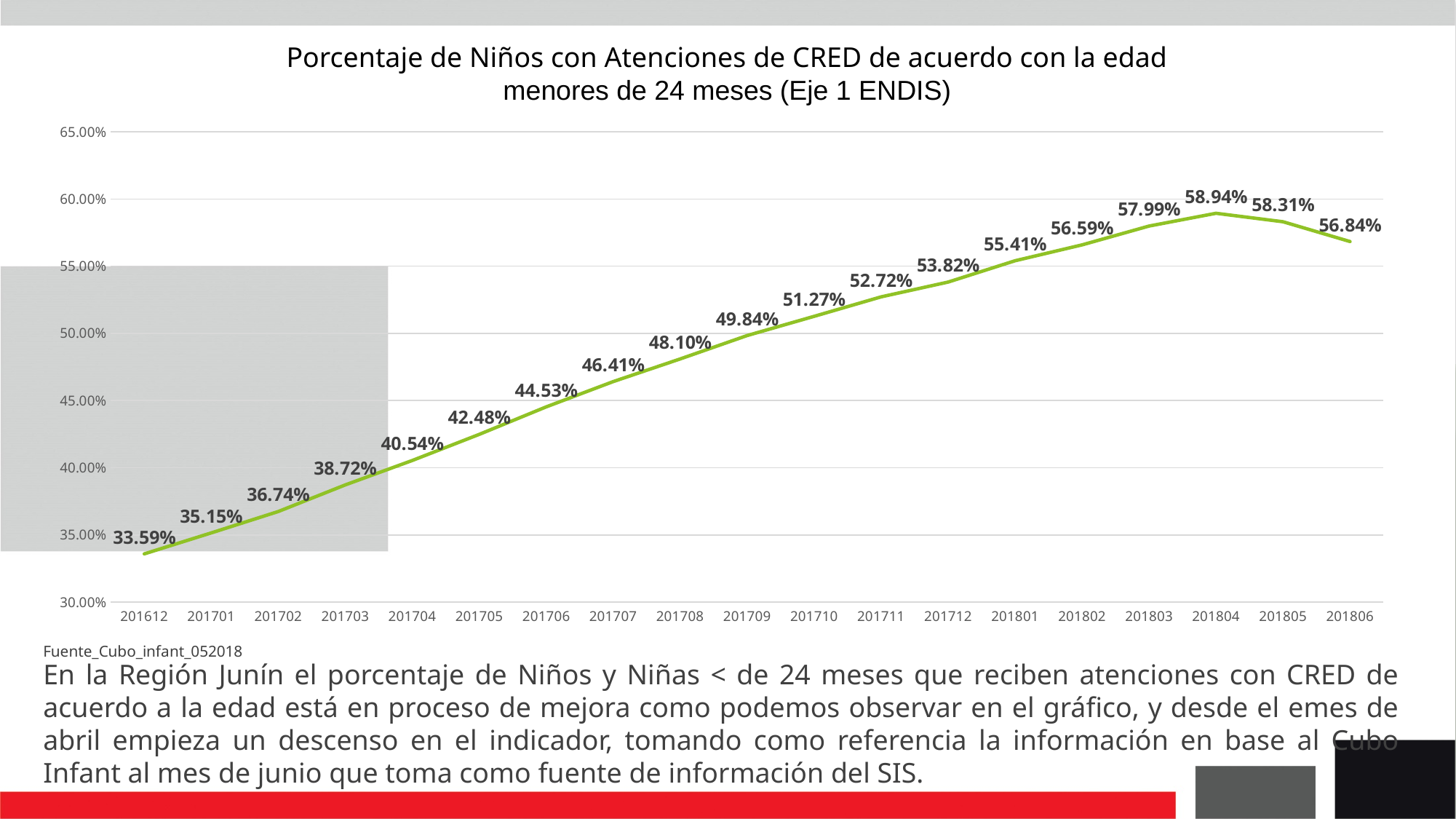
What is the value for 201806? 56.84% What is the value for 201612? 33.59% What type of chart is shown on the slide? line chart What is the source note printed below the chart? Fuente_Cubo_infant_052018 How many data points are plotted on the chart? 19 What is the value for 201709? 49.84% Is the value for 201710 greater or less than 50.00%? greater What is the difference between the values for 201701 and 201612? 1.56% Which period has the lowest value? 201612 What is the difference between the values for 201804 and 201806? 2.10% Which is larger, the value for 201805 or the value for 201803? 201805 Which period has the highest value? 201804